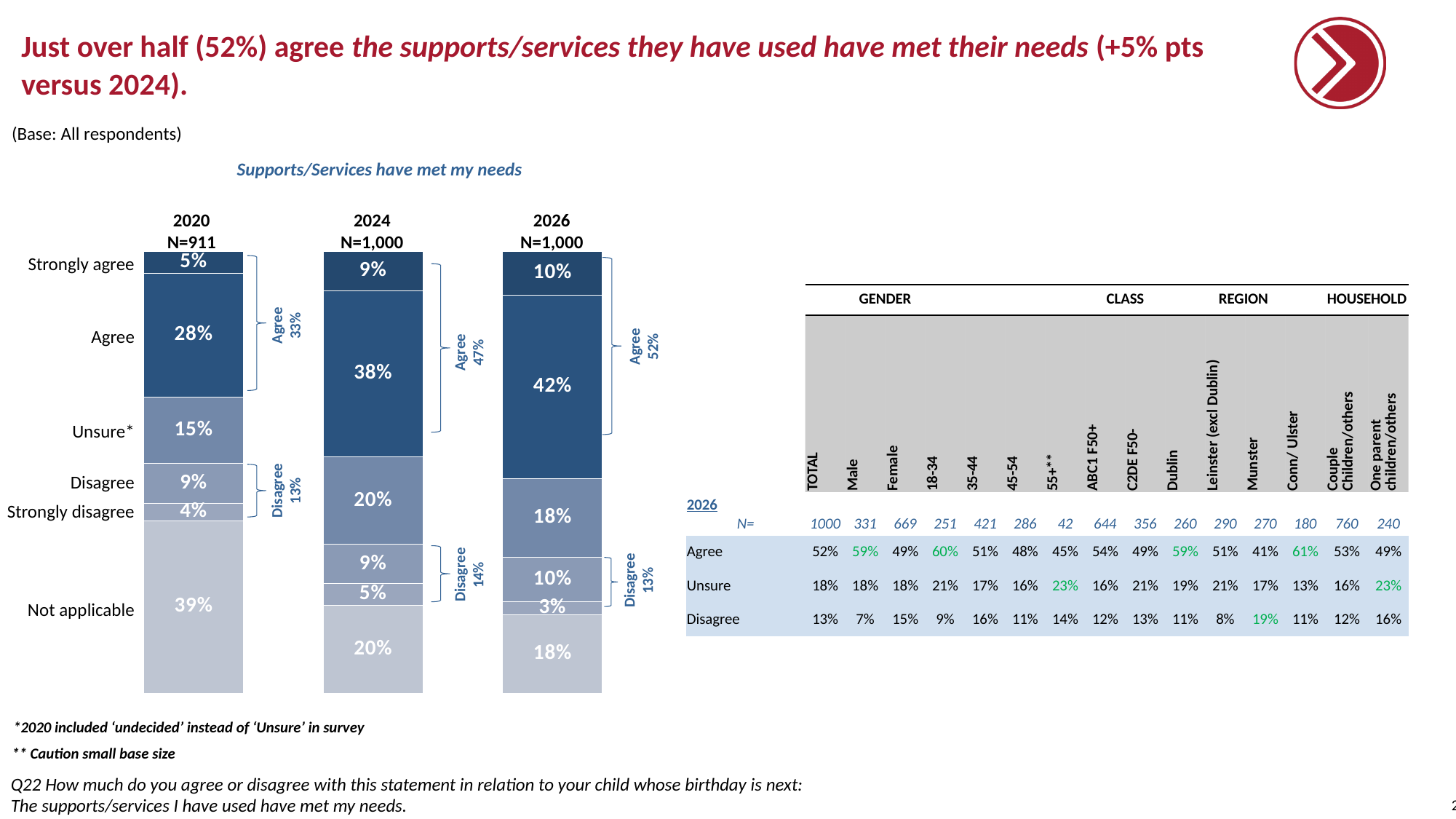
What percentage of respondents chose 'Not applicable' in 2020? 39% What is the combined 'Agree' total (Strongly agree plus Agree) for 2024? 47% What is the 'Strongly disagree' value for 2024? 5% Is the 'Not applicable' value larger in 2020 or in 2026? 2020 What is the chart's title? Supports/Services have met my needs What is the difference between the 'Agree' values for 2026 and 2024? 4% How does the combined 'Agree' total change from 2020 to 2026? It rises What kind of chart is shown on the slide? Stacked bar chart Which year has the lowest 'Unsure' value? 2020 Which year has the highest 'Strongly agree' value? 2026 How many bars (years) does the chart show? 3 What percentage of respondents chose 'Agree' in 2026? 42%